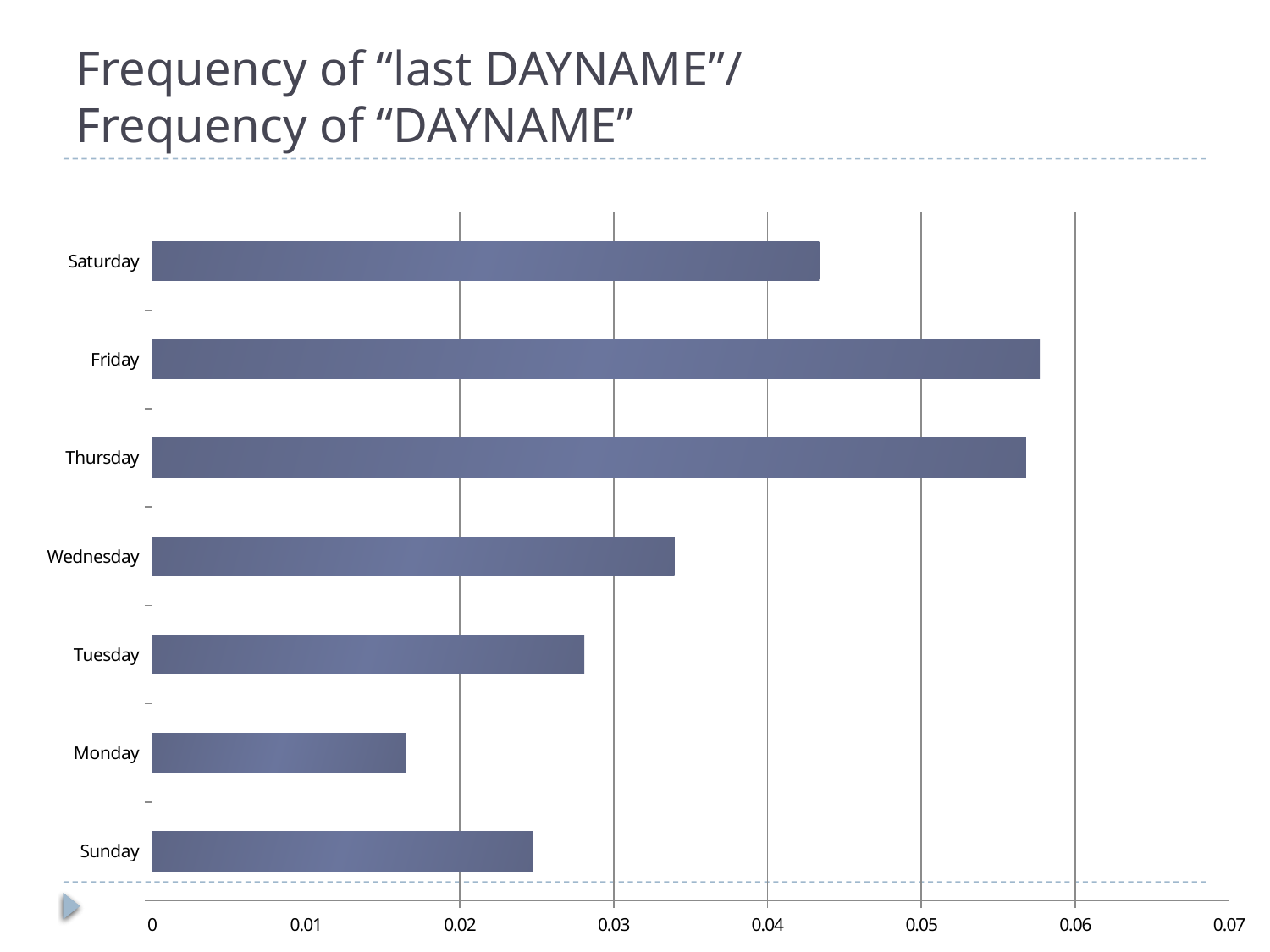
Is the value for Wednesday greater or less than 0.03? greater Is the value for Friday greater or less than 0.05? greater Which has the larger value, Saturday or Wednesday? Saturday What is the title of the slide containing the chart? Frequency of "last DAYNAME"/ Frequency of "DAYNAME" How many day categories are plotted on the chart? 7 Which day has the lowest value on the chart? Monday Is the value for Monday greater or less than 0.02? less What kind of chart is shown on the slide? bar chart Which has the larger value, Sunday or Monday? Sunday